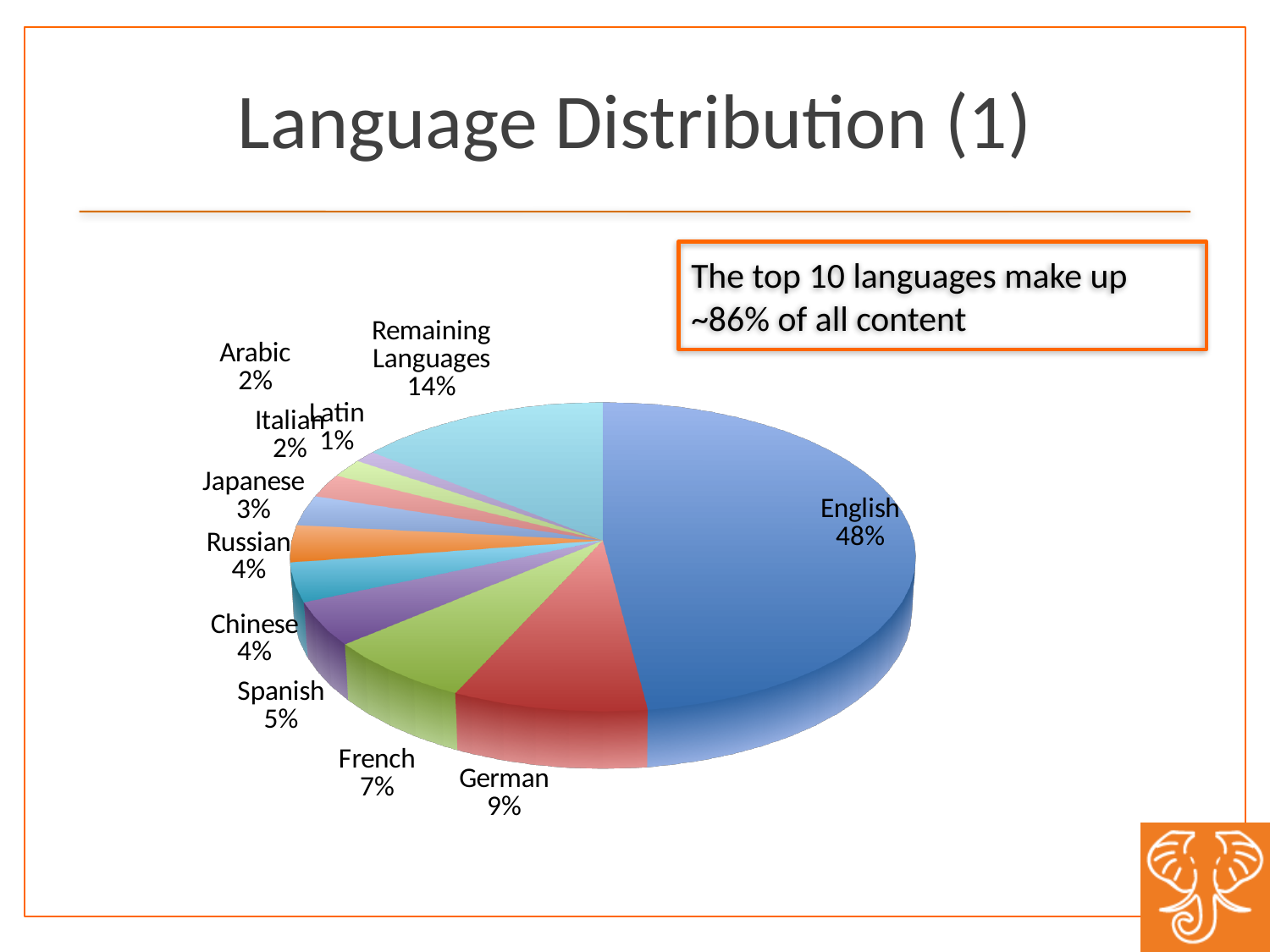
What is the title of the slide containing the pie chart? Language Distribution (1) Which language has the smallest slice of the pie? Latin Which slice of the pie is the largest? English What is the value shown for Japanese? 3% How many slices does the pie chart have? 11 What kind of chart is shown on the slide? pie chart What is the value shown for German? 9% What is the value shown for Remaining Languages? 14% What share of the pie does English account for? 48% What is the difference between the shares for English and German? 39% What is the difference between the shares for French and Spanish? 2% Which is larger, the share for French or the share for Chinese? French